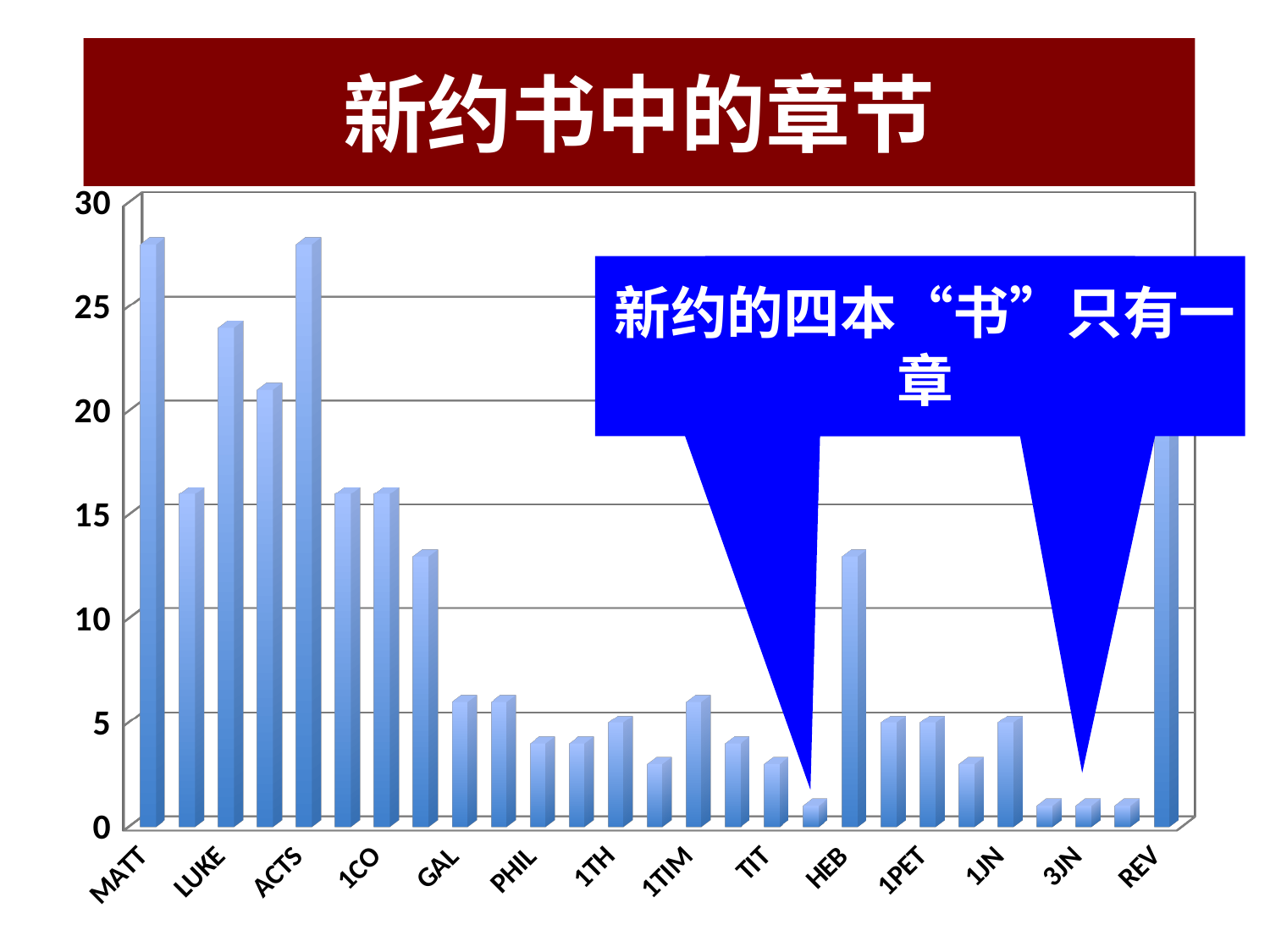
Is the value for 3JN greater or less than 5? less What kind of chart is shown on the slide? bar chart Is the value for MATT greater or less than 25? greater What is the title of the chart? 新约书中的章节 What does the blue callout on the chart say? 新约的四本“书”只有一章 Is the value for LUKE greater or less than 25? less Which is larger, the value for HEB or the value for GAL? HEB How many bars are plotted in the chart? 27 Which is larger, the value for MATT or the value for LUKE? MATT